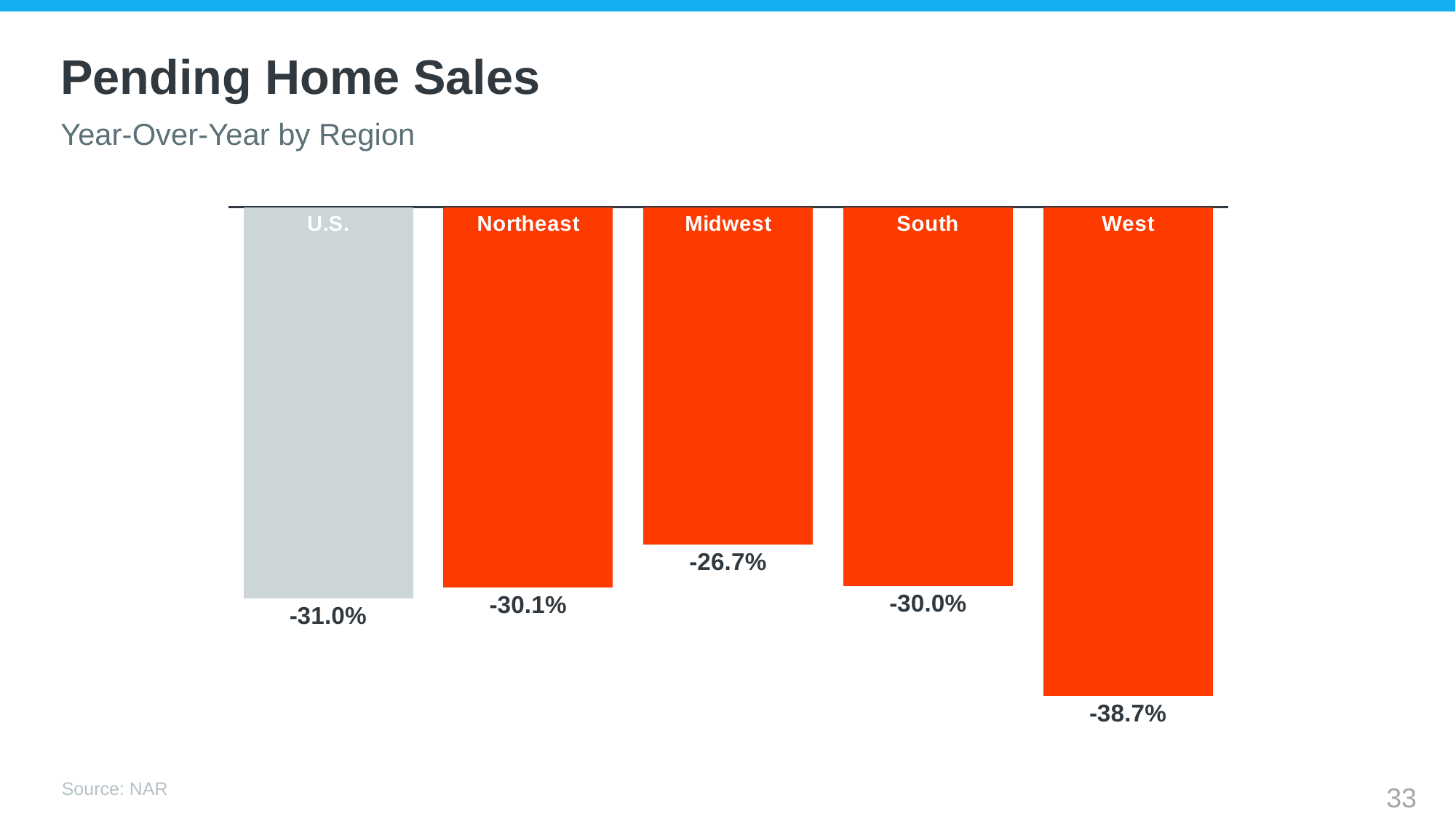
What is the year-over-year change in pending home sales for the South? -30.0% What type of chart is shown on the slide? Bar chart What is the year-over-year change in pending home sales for the West? -38.7% Which bar is shown in grey rather than orange? U.S. What is the year-over-year change in pending home sales for the Northeast? -30.1% Which region shows the smallest year-over-year decline in pending home sales? Midwest What is the year-over-year change in pending home sales for the Midwest? -26.7% What is the year-over-year change in pending home sales for the U.S. overall? -31.0% Which has a larger year-over-year decline, the U.S. overall or the Midwest? U.S. How many bars are shown in the chart? 5 Which region shows the largest year-over-year decline in pending home sales? West By how many percentage points does the West's decline exceed the Midwest's decline? 12.0 percentage points